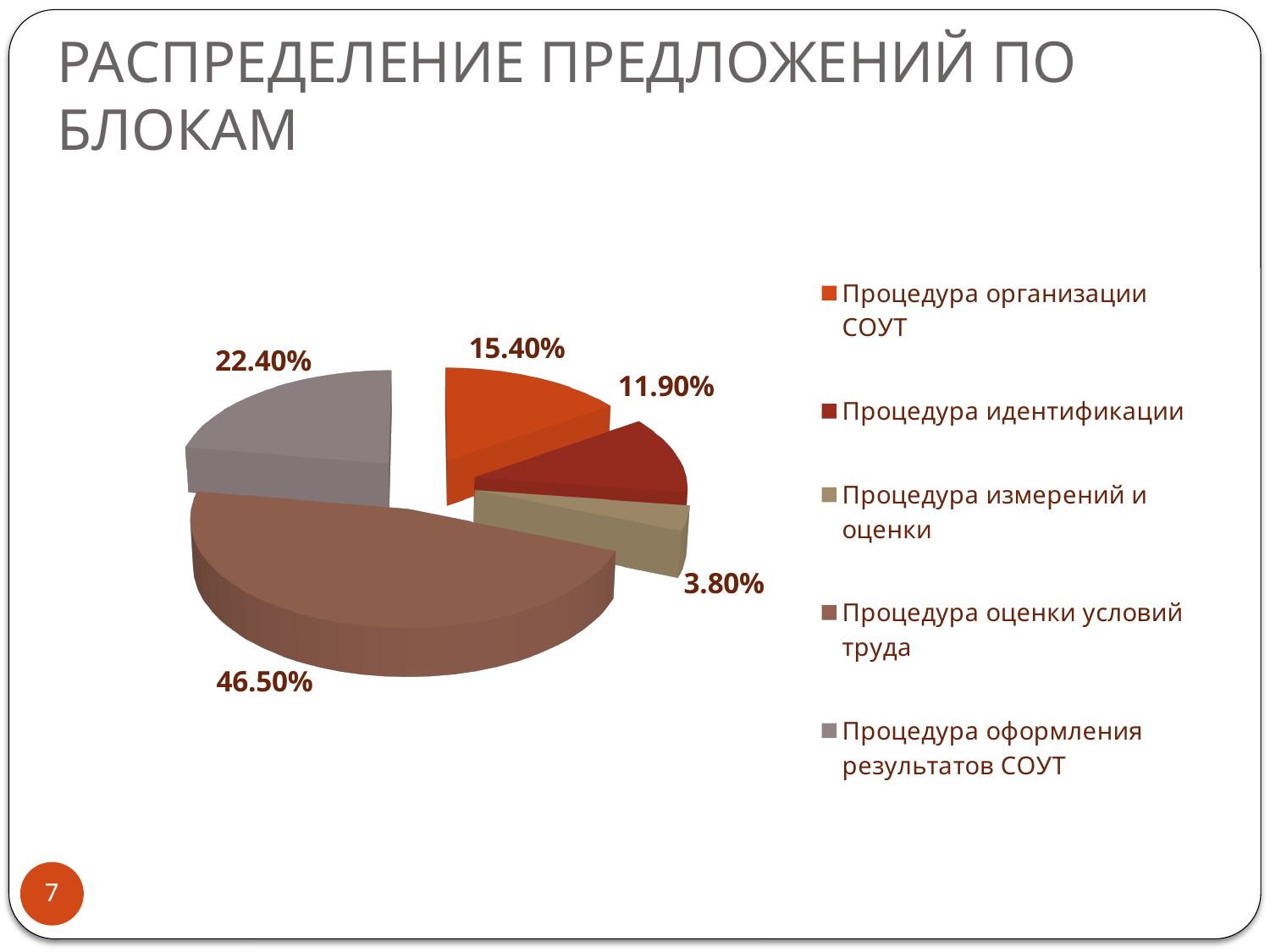
What share of the pie does Процедура оценки условий труда have? 46.50% What is the difference between the shares of Процедура оценки условий труда and Процедура оформления результатов СОУТ? 24.10% What is the value shown for Процедура организации СОУТ? 15.40% What is the value shown for Процедура измерений и оценки? 3.80% How many categories does the pie chart show? 5 Which category has the smallest slice of the pie? Процедура измерений и оценки What is the value shown for Процедура идентификации? 11.90% Which is larger: the share for Процедура организации СОУТ or for Процедура идентификации? Процедура организации СОУТ What is the title of the slide containing the chart? РАСПРЕДЕЛЕНИЕ ПРЕДЛОЖЕНИЙ ПО БЛОКАМ What is the value shown for Процедура оформления результатов СОУТ? 22.40% What kind of chart is shown on the slide? Pie chart Which category has the largest slice of the pie? Процедура оценки условий труда